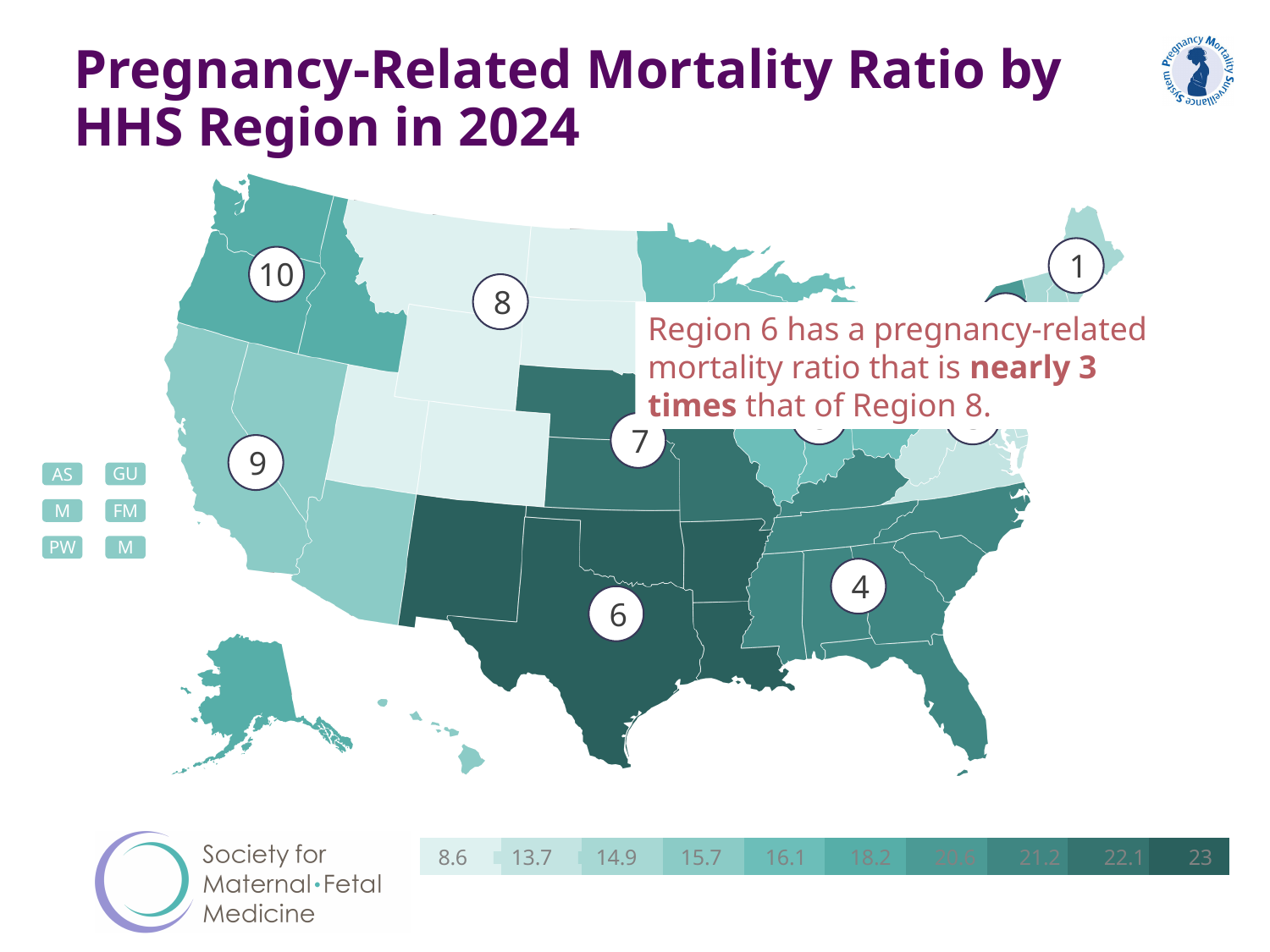
What is the lowest value shown in the colour legend? 8.6 What is the highest value shown in the colour legend? 23 What is the title of the chart on the slide? Pregnancy-Related Mortality Ratio by HHS Region in 2024 According to the colour legend, what is the pregnancy-related mortality ratio for Region 6? 23 According to the colour legend, what is the pregnancy-related mortality ratio for Region 8? 8.6 Which has the higher pregnancy-related mortality ratio, Region 4 or Region 9? Region 4 Which labelled HHS region is shaded with the lightest colour on the map? Region 8 Which has the higher pregnancy-related mortality ratio, Region 6 or Region 8? Region 6 What kind of chart is shown on the slide? Map (choropleth map) How many values are listed in the colour legend at the bottom of the map? 10 According to the callout text, Region 6's pregnancy-related mortality ratio is nearly how many times that of Region 8? Nearly 3 times Which labelled HHS region is shaded with the darkest colour on the map? Region 6